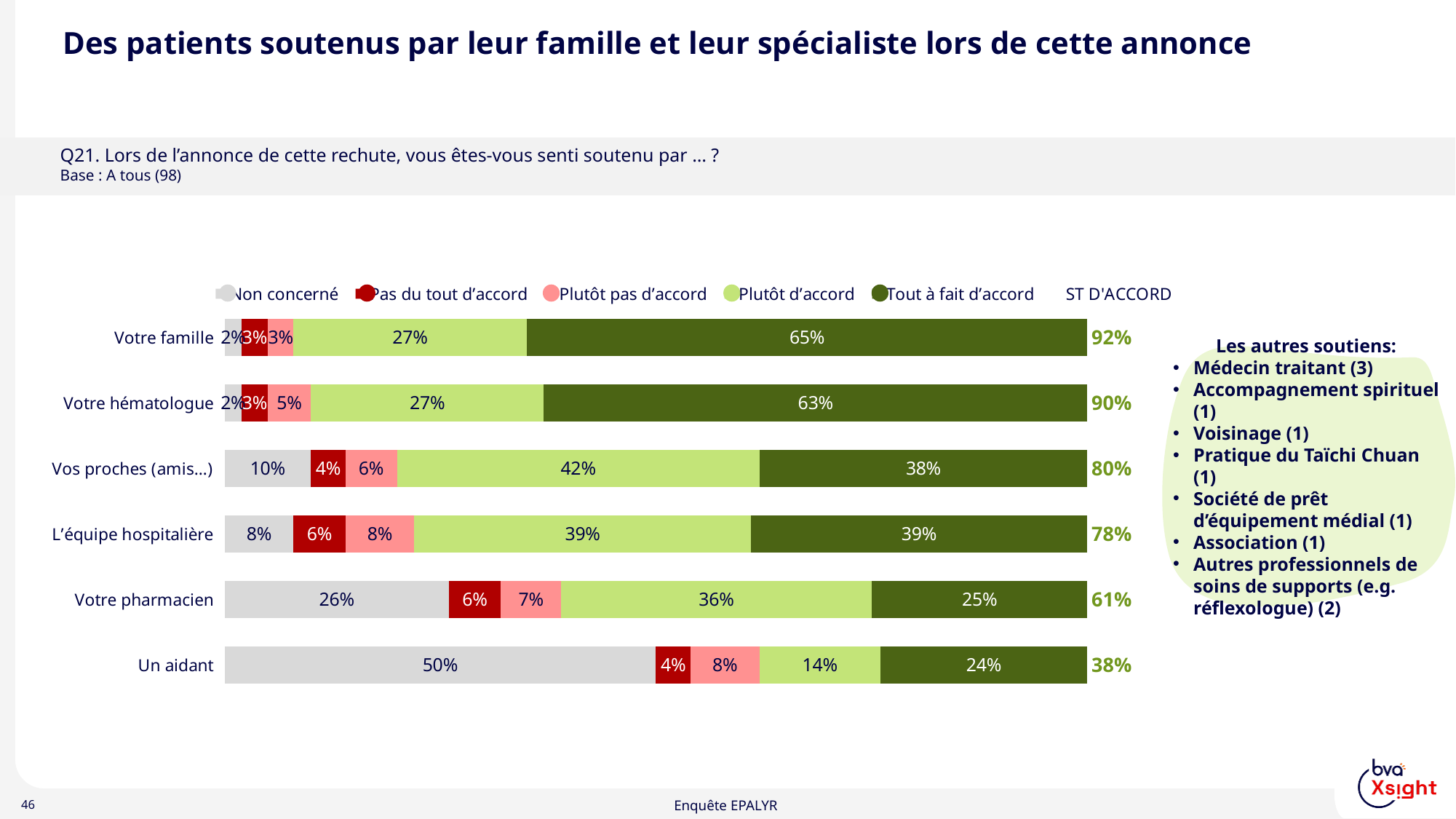
What is the 'Non concerné' value for 'Un aidant'? 50% What is the sum of 'Plutôt d'accord' and 'Tout à fait d'accord' for 'L'équipe hospitalière'? 78% How many categories are shown in the chart? 6 Which category has the lowest 'Tout à fait d'accord' value? Un aidant What is the 'Plutôt d'accord' value for 'Vos proches (amis…)'? 42% Which is larger: the 'Non concerné' value for 'Votre pharmacien' or for 'L'équipe hospitalière'? Votre pharmacien What is the 'Tout à fait d'accord' value for 'Votre famille'? 65% Which category has the highest ST D'ACCORD value? Votre famille What is the ST D'ACCORD value for 'Votre pharmacien'? 61% What kind of chart is shown on the slide? Stacked bar chart How many series does the legend list? 6 What is the difference between the ST D'ACCORD values for 'Votre famille' and 'Votre hématologue'? 2%